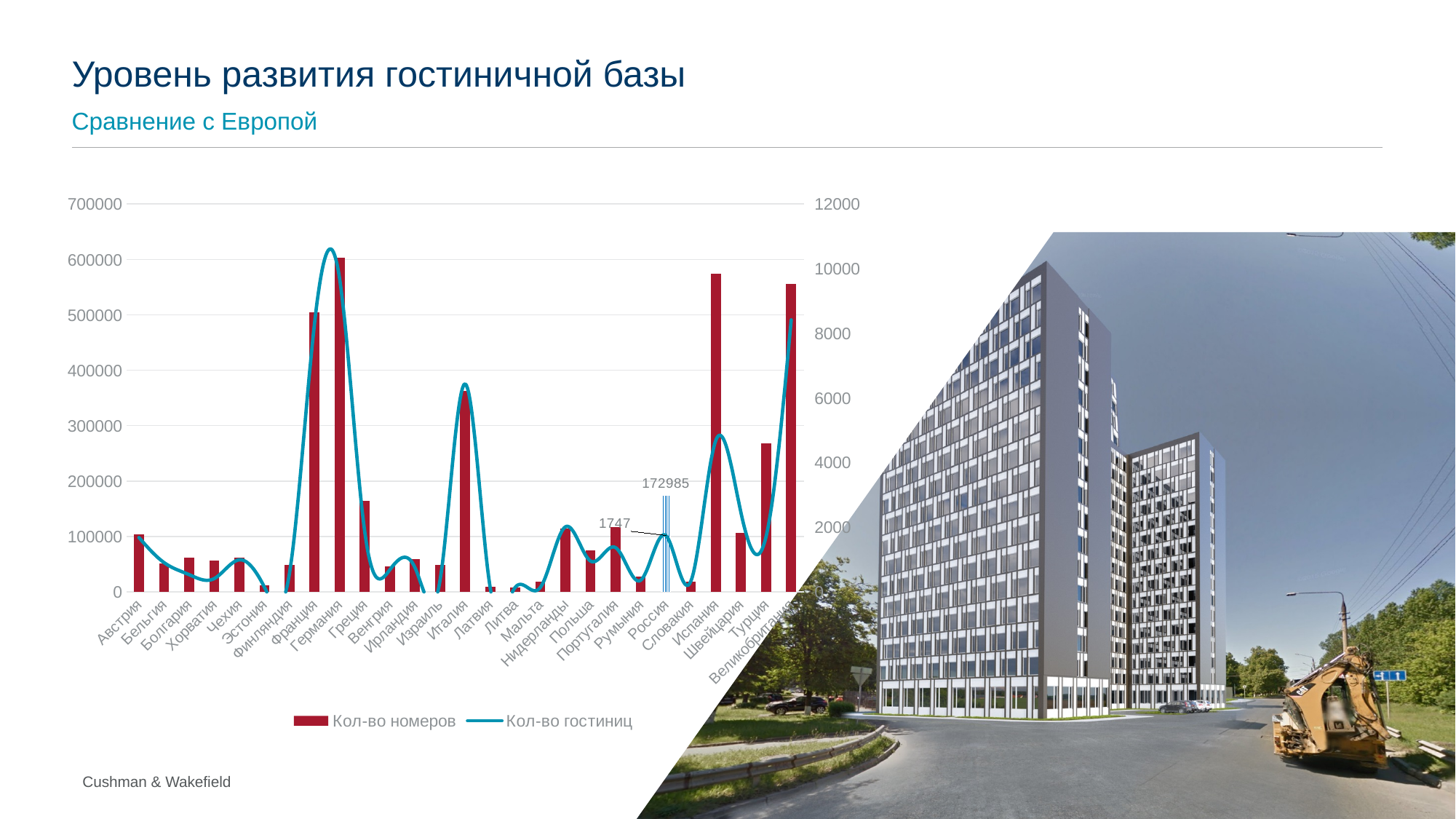
Which country has the highest point on the Кол-во гостиниц line? Германия Is the Кол-во гостиниц value for Испания greater or less than 4000? greater Which country has the highest Кол-во номеров bar? Германия What is the value of Кол-во гостиниц for Россия? 1747 How many series does the chart legend list? 2 Is the Кол-во номеров value for Турция greater or less than 200000? greater Is the Кол-во номеров value for Франция greater or less than 400000? greater Which has the larger Кол-во номеров bar, Италия or Турция? Италия How many countries are shown on the x axis of the chart? 27 Which has the larger Кол-во номеров bar, Германия or Франция? Германия What is the value of Кол-во номеров for Россия? 172985